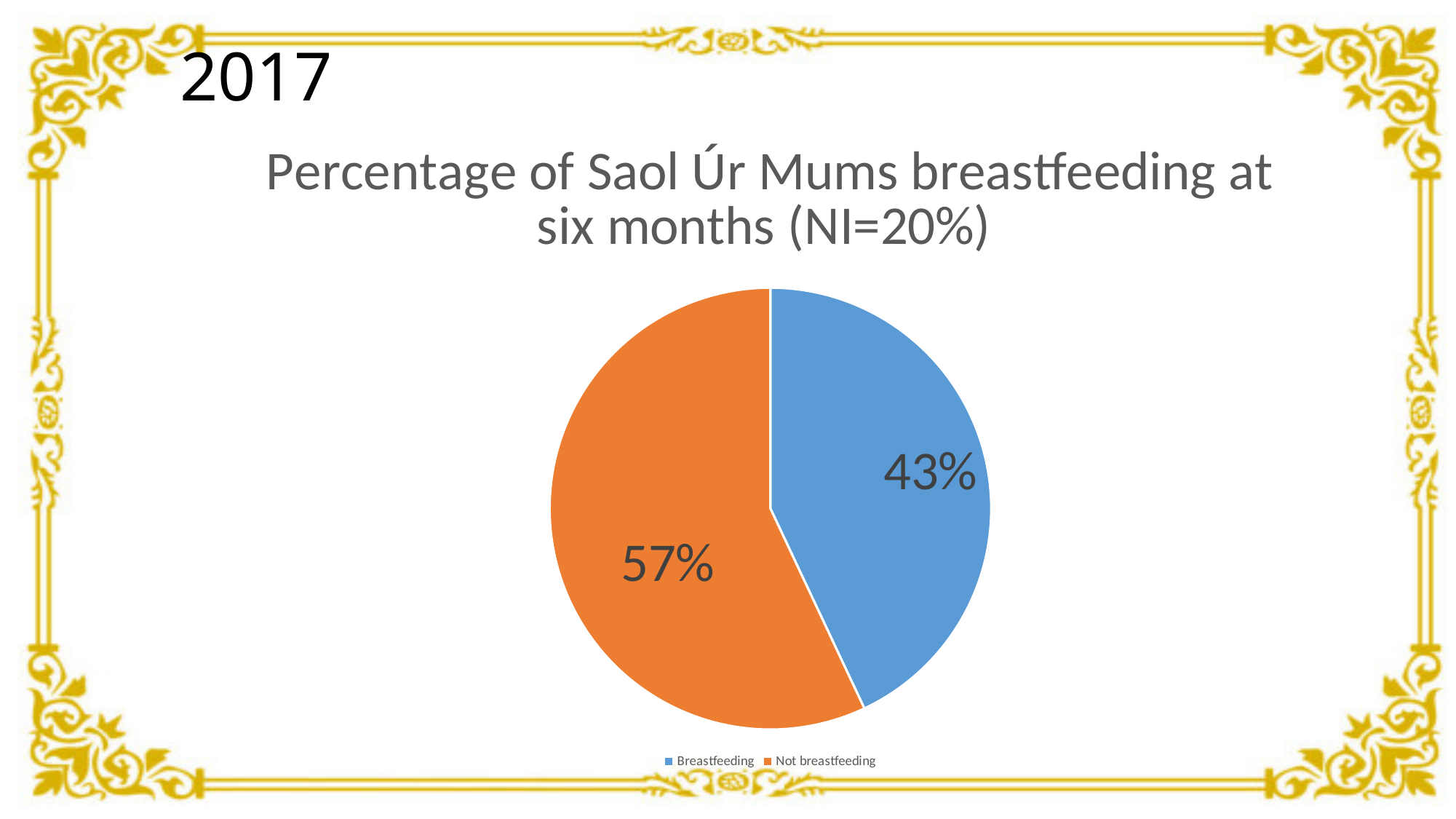
Which is larger, the Breastfeeding slice or the Not breastfeeding slice? Not breastfeeding What kind of chart is shown on the slide? Pie chart What is the difference in percentage points between the Not breastfeeding and Breastfeeding slices? 14 What colour is the Not breastfeeding slice? Orange How many slices does the pie chart have? 2 Which slice of the pie is the smallest? Breastfeeding What percentage of Saol Úr Mums were not breastfeeding at six months? 57% What percentage of Saol Úr Mums were breastfeeding at six months? 43% What is the title of the chart? Percentage of Saol Úr Mums breastfeeding at six months (NI=20%) Which slice of the pie is the largest? Not breastfeeding How many entries does the legend list? 2 What share of the pie does the Breastfeeding slice represent? 43%